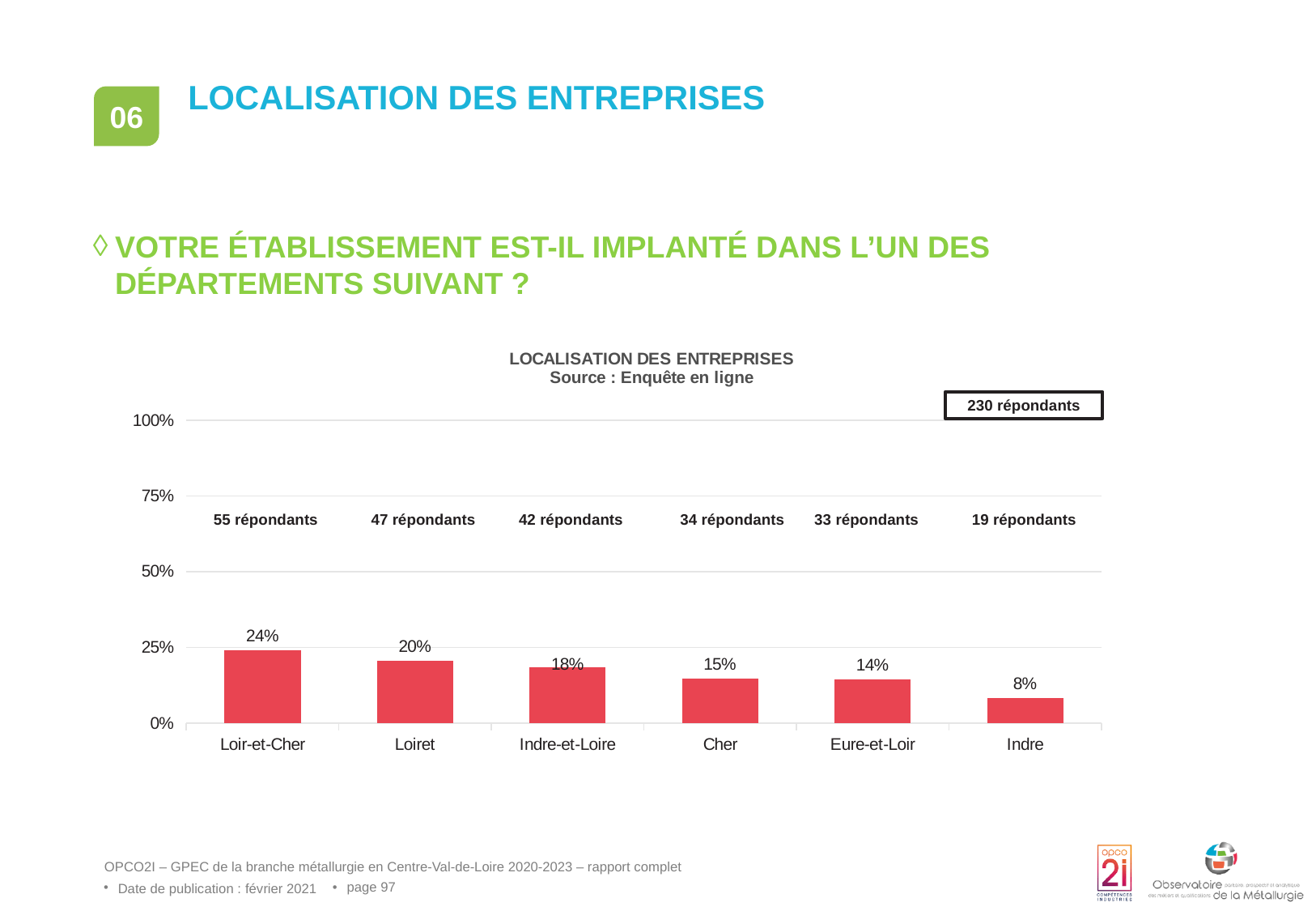
Is the value for Loir-et-Cher greater or less than 50%? less What percentage is shown for Indre? 8% Which department has the lowest percentage? Indre Which is larger, the value for Loiret or the value for Eure-et-Loir? Loiret What percentage is shown for Loir-et-Cher? 24% What percentage is shown for Cher? 15% What kind of chart is shown? bar chart What is the difference in percentage points between Loiret and Indre-et-Loire? 2 Which department has the highest percentage? Loir-et-Cher Do the values rise or fall from left to right along the x axis? fall How many departments are shown on the x axis? 6 How many respondents are indicated for Indre-et-Loire? 42 répondants